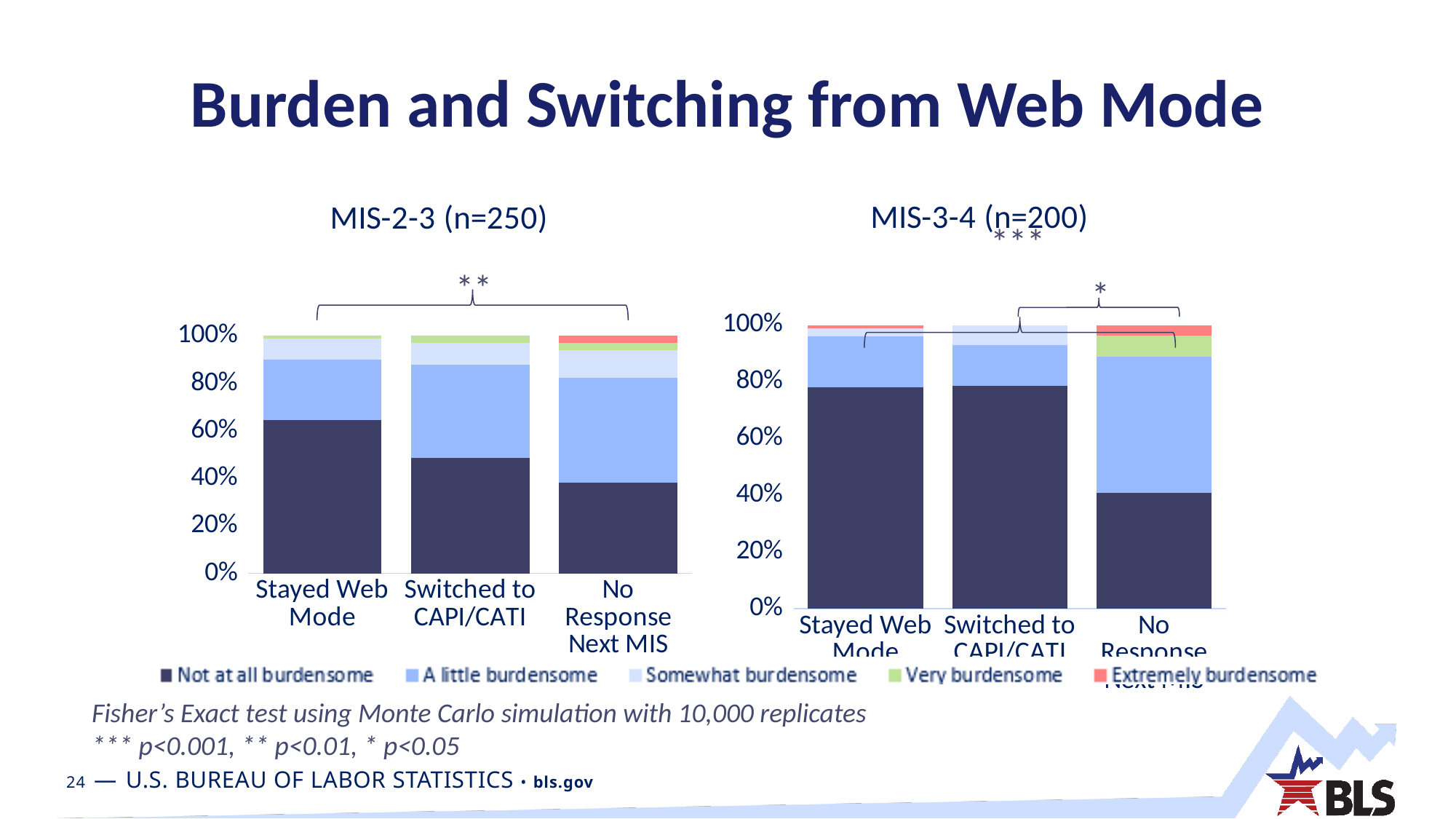
In the MIS-2-3 (n=250) chart, which category has the largest 'Not at all burdensome' segment? Stayed Web Mode What kind of chart is the MIS-2-3 (n=250) chart? Stacked bar chart How many series does the legend list for the charts? 5 How many categories are shown on the x axis of the MIS-3-4 (n=200) chart? 3 In the MIS-2-3 (n=250) chart, is the 'Not at all burdensome' share for Stayed Web Mode greater or less than 60%? greater In the MIS-2-3 (n=250) chart, which has a larger 'Not at all burdensome' share: Stayed Web Mode or Switched to CAPI/CATI? Stayed Web Mode In the MIS-3-4 (n=200) chart, which category has the smallest 'Not at all burdensome' segment? No Response Next MIS In the MIS-3-4 (n=200) chart, is the 'Not at all burdensome' share for Stayed Web Mode greater or less than 60%? greater In the MIS-2-3 (n=250) chart, is the 'Not at all burdensome' share for No Response Next MIS greater or less than 40%? less Which legend entry is shown in green? Very burdensome In the MIS-2-3 (n=250) chart, which category has the smallest 'Not at all burdensome' segment? No Response Next MIS